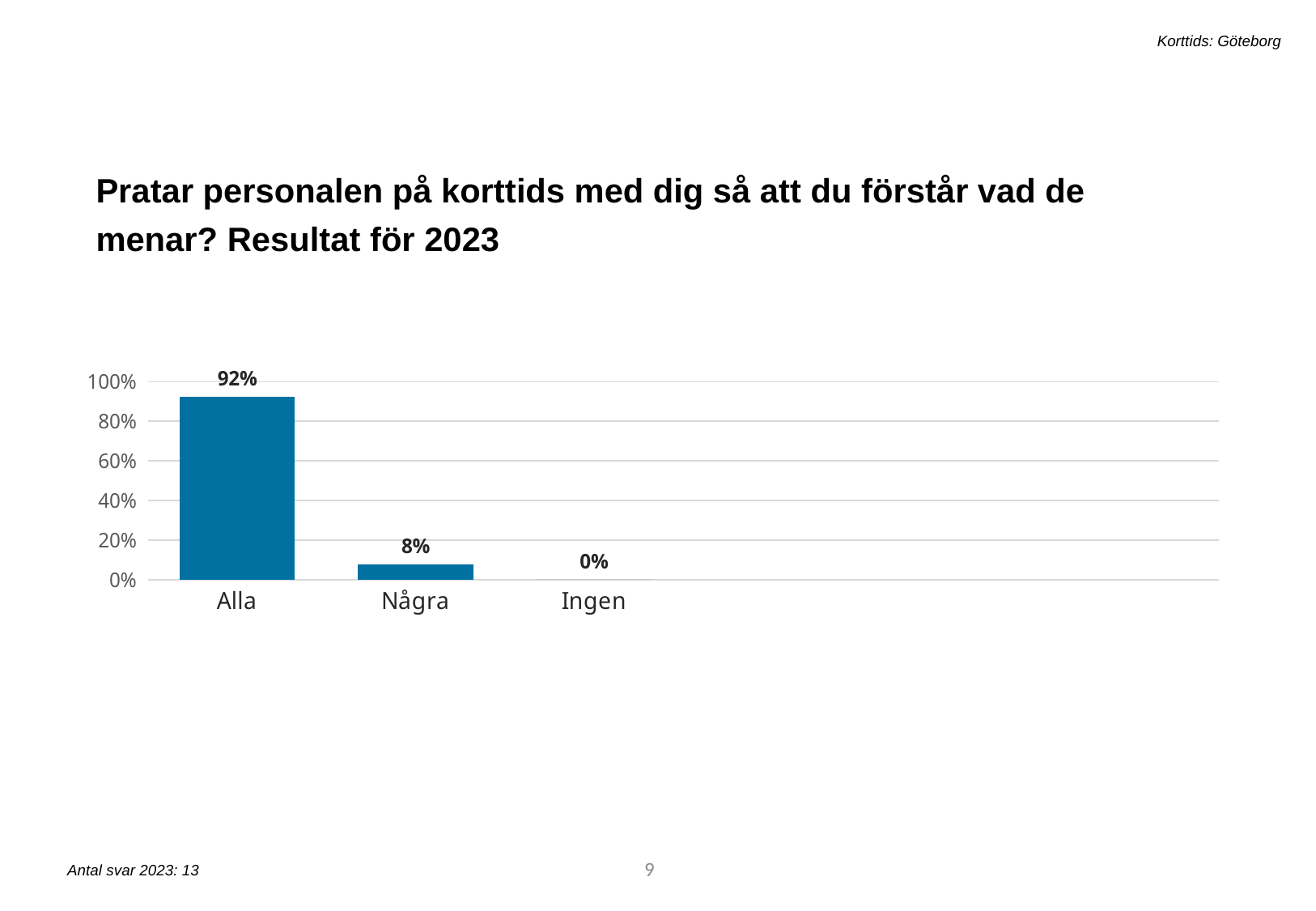
Which is larger, the value for Några or the value for Ingen? Några What is the value for Ingen? 0% Is the value for Alla greater or less than 80%? greater Is the value for Några greater or less than 20%? less Which category has the lowest value? Ingen How many categories are shown on the x axis? 3 Which category has the highest value? Alla What kind of chart is shown on the slide? bar chart Do the values rise or fall from left to right along the x axis? fall What is the value for Några? 8% What is the difference between the values for Alla and Några? 84% What is the value for Alla? 92%